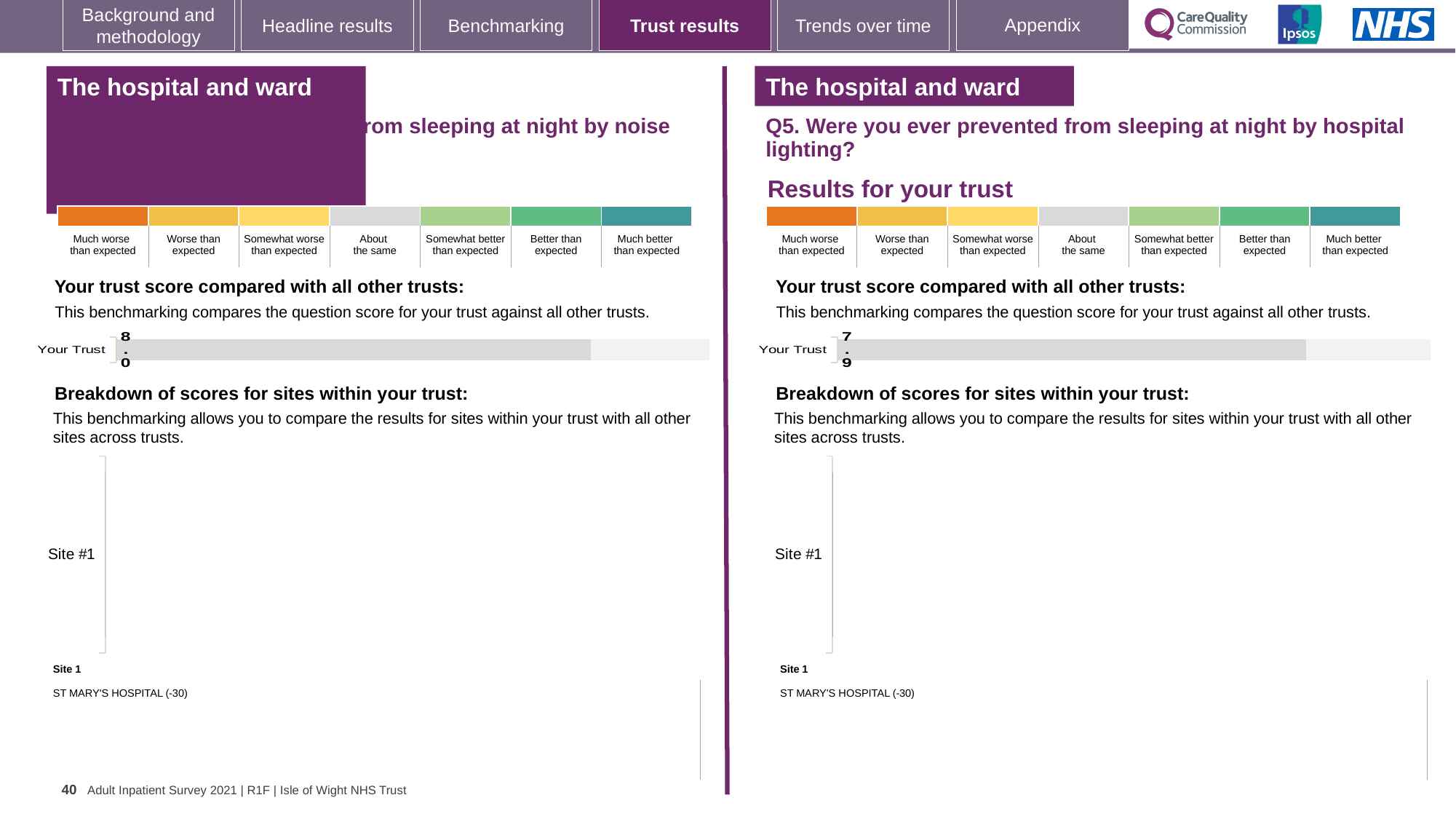
What is the difference between the Your Trust score on the left chart (8.0) and the Your Trust score on the right chart (7.9)? 0.1 Is the Your Trust score on the right chart (Q5, hospital lighting) greater or less than 8? less What is the label of the single category plotted in the right-hand 'Your trust score compared with all other trusts' chart? Your Trust On the left 'Your trust score compared with all other trusts' chart, how many categories are plotted? 1 What kind of chart is used to show 'Your trust score compared with all other trusts' on the right side of the slide? Bar chart On the left chart under 'Your trust score compared with all other trusts', what is the score shown for Your Trust? 8.0 On the right chart (Q5, hospital lighting) under 'Your trust score compared with all other trusts', what is the score shown for Your Trust? 7.9 Which is larger: the Your Trust score on the left chart (noise) or the Your Trust score on the right chart (Q5, hospital lighting)? The left chart (noise), 8.0 How many rating categories does the colour scale above the right-hand chart list, from 'Much worse than expected' to 'Much better than expected'? 7 In the 'Breakdown of scores for sites within your trust' chart on the right, what is the label of the site shown on the axis? Site #1